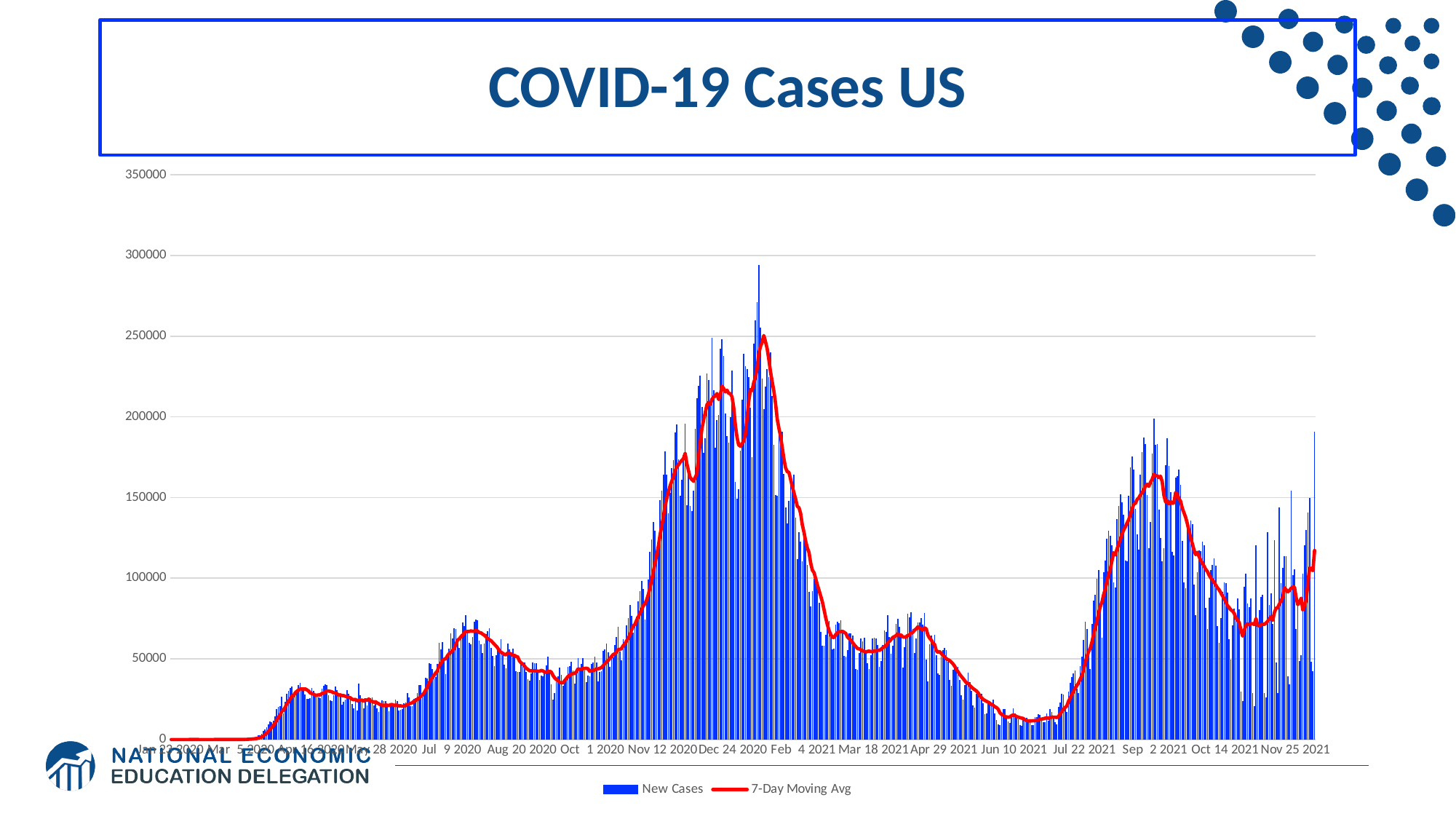
Is the 7-Day Moving Avg at Sep 2 2021 greater or less than 100000? greater Is the 7-Day Moving Avg at Mar 18 2021 greater or less than 100000? less What are the two series named in the legend? New Cases and 7-Day Moving Avg What kind of chart is this? A bar chart with a line overlay How many series does the legend list? 2 What is the title of the chart? COVID-19 Cases US Between Jun 10 2021 and Sep 2 2021, does the 7-Day Moving Avg rise or fall? rise Is the peak of the 7-Day Moving Avg greater or less than 300000? less Is the 7-Day Moving Avg higher at Dec 24 2020 or at Jul 22 2021? Dec 24 2020 Between Feb 4 2021 and Mar 18 2021, does the 7-Day Moving Avg rise or fall? fall